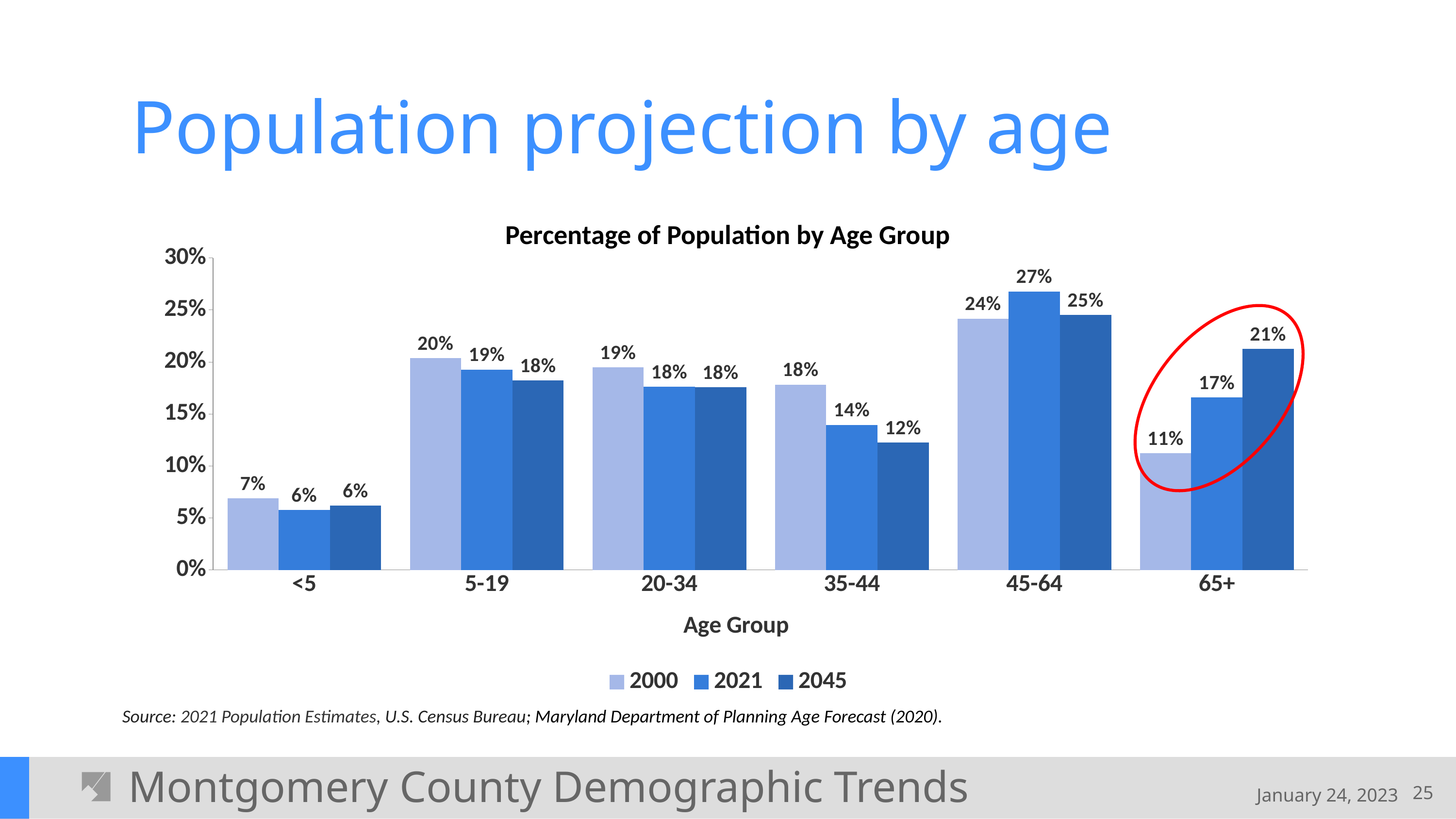
What is the difference between the 2000 and 2045 values for the 35-44 age group? 6% What is the value for the 35-44 age group in the 2000 series? 18% What kind of chart is shown on the slide? Bar chart What is the value for the 65+ age group in the 2045 series? 21% Which age group has the lowest value in the 2045 series? <5 Which age group has the highest value in the 2021 series? 45-64 What is the difference between the 2045 and 2000 values for the 65+ age group? 10% Is the 2000 value for the 45-64 age group greater or less than 20%? greater How many age groups are shown on the x axis? 6 What is the value for the <5 age group in the 2021 series? 6% How many series does the legend list? 3 Which is larger for the 45-64 age group: the 2021 value or the 2045 value? 2021